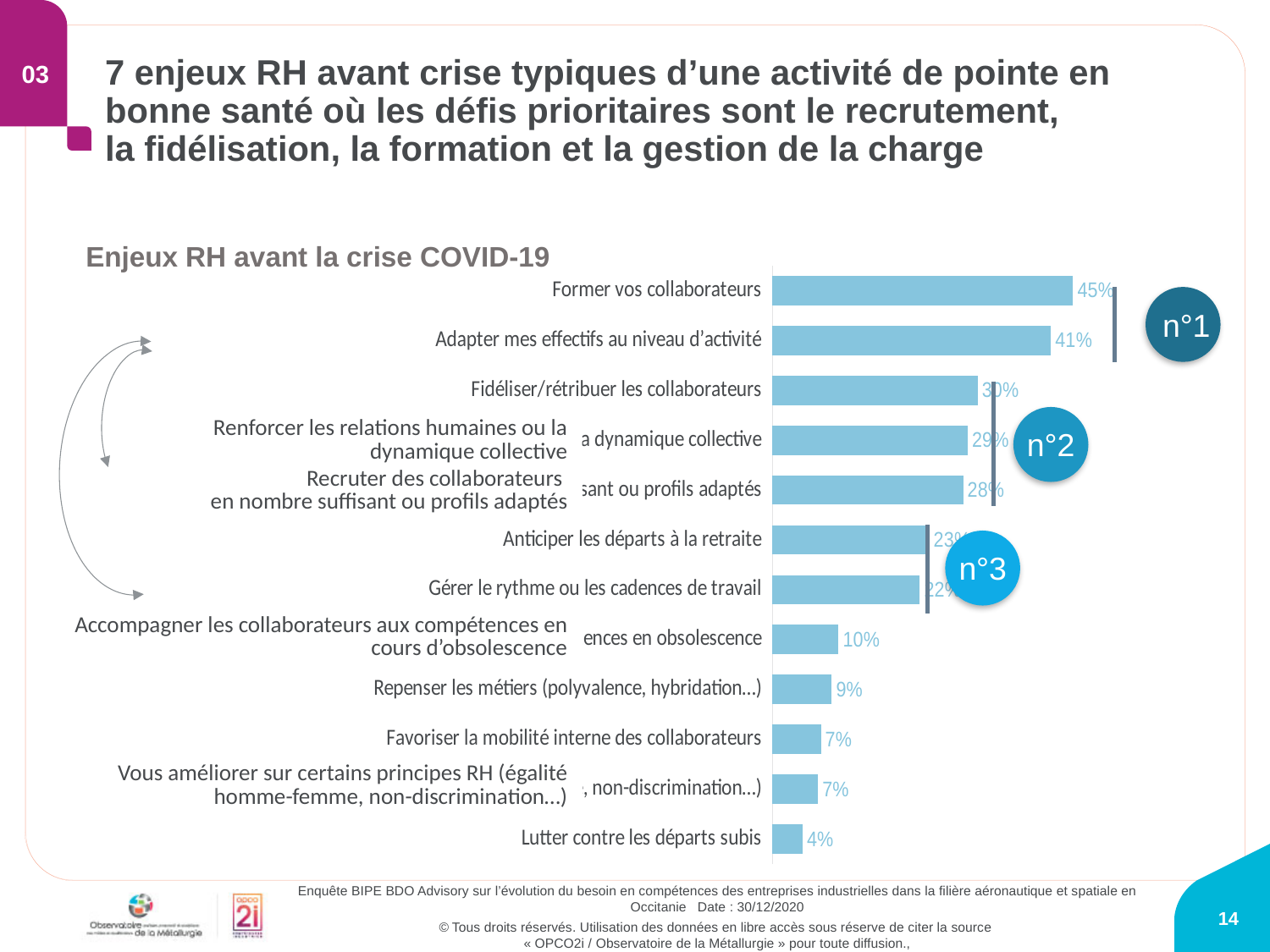
What is the value for 'Repenser les métiers (polyvalence, hybridation…)'? 9% What is the value for 'Former vos collaborateurs'? 45% Which category has the highest value? Former vos collaborateurs What is the value for 'Lutter contre les départs subis'? 4% What type of chart is shown on the slide? Bar chart What is the title of the chart? Enjeux RH avant la crise COVID-19 Which category has the lowest value? Lutter contre les départs subis How many categories are plotted in the chart? 12 Which is larger: the value for 'Repenser les métiers (polyvalence, hybridation…)' or for 'Favoriser la mobilité interne des collaborateurs'? Repenser les métiers (polyvalence, hybridation…) What is the value for 'Accompagner les collaborateurs aux compétences en cours d'obsolescence'? 10% What is the difference between the values for 'Former vos collaborateurs' and 'Adapter mes effectifs au niveau d'activité'? 4 percentage points What is the value for 'Adapter mes effectifs au niveau d'activité'? 41%